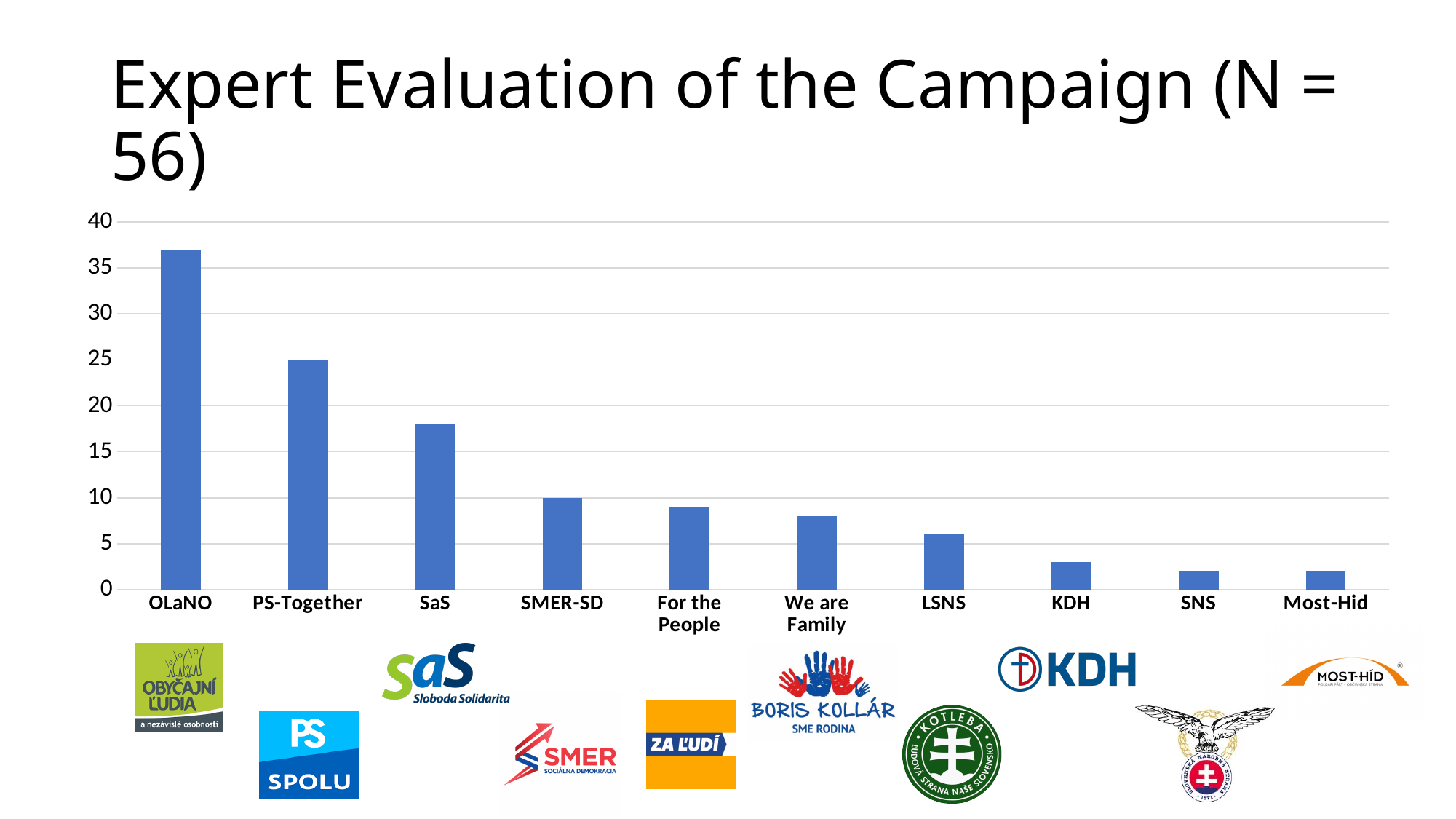
Is the value for LSNS greater or less than 5? greater Which has a larger value, SaS or SMER-SD? SaS Which party has the highest value in the chart? OLaNO Do the values generally rise or fall moving from left to right along the x axis? fall How many parties (categories) are shown on the x axis of the chart? 10 Is the value for KDH greater or less than 5? less Is the value for SaS greater or less than 20? less Which has a larger value, LSNS or KDH? LSNS What kind of chart is shown on the slide? bar chart What is the title of the chart on the slide? Expert Evaluation of the Campaign (N = 56)